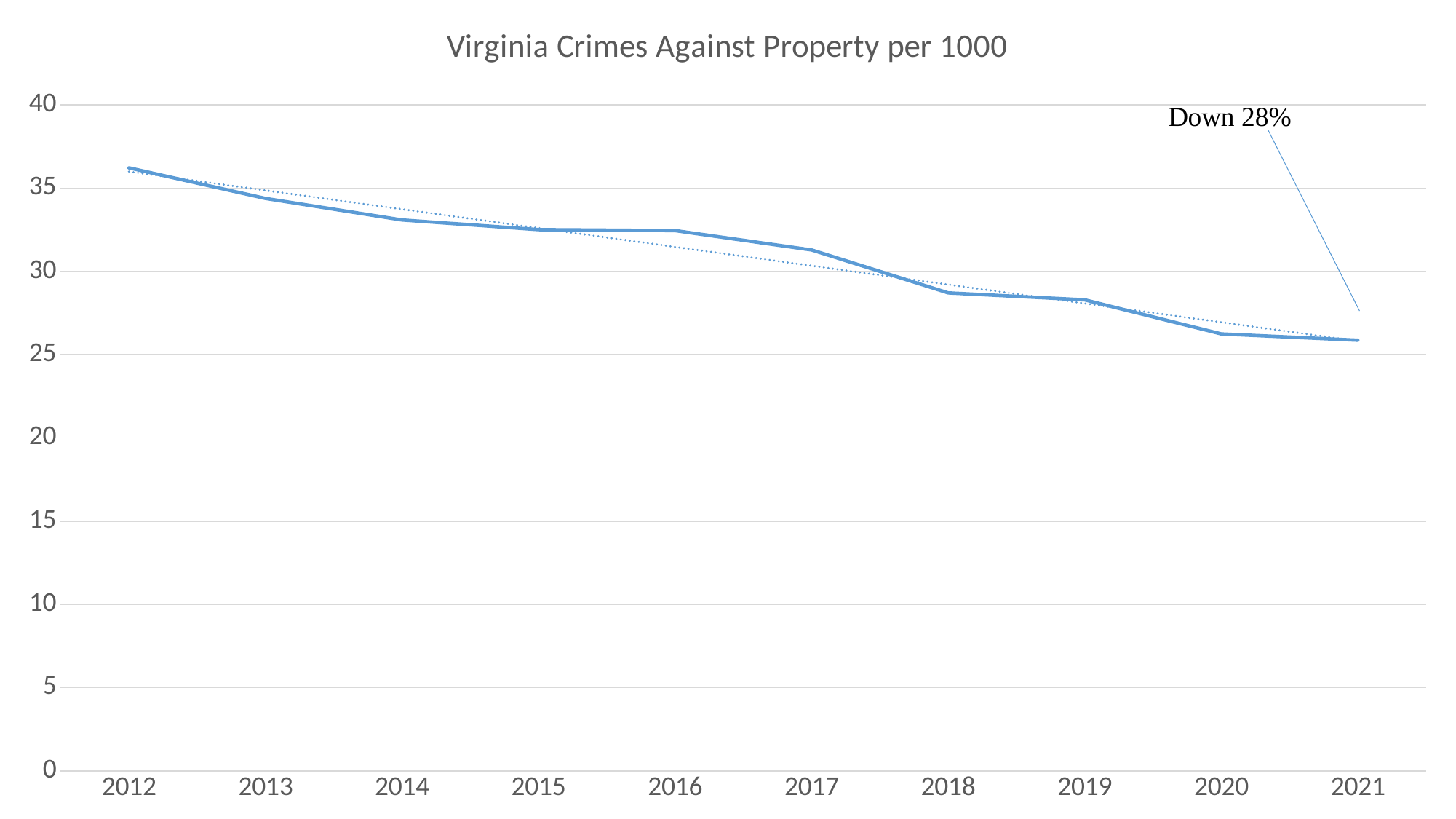
Which year has the lowest value? 2021 What is the title of the chart? Virginia Crimes Against Property per 1000 Is the value for 2018 greater or less than 30? less Do the values rise or fall from 2012 to 2021? fall Is the value for 2016 greater or less than 30? greater What kind of chart is shown on the slide? line chart Which year has the highest value? 2012 Is the value for 2021 greater or less than 30? less What percentage decline does the annotation on the chart state? Down 28% Which year has the larger value, 2014 or 2020? 2014 How many years are plotted along the x axis? 10